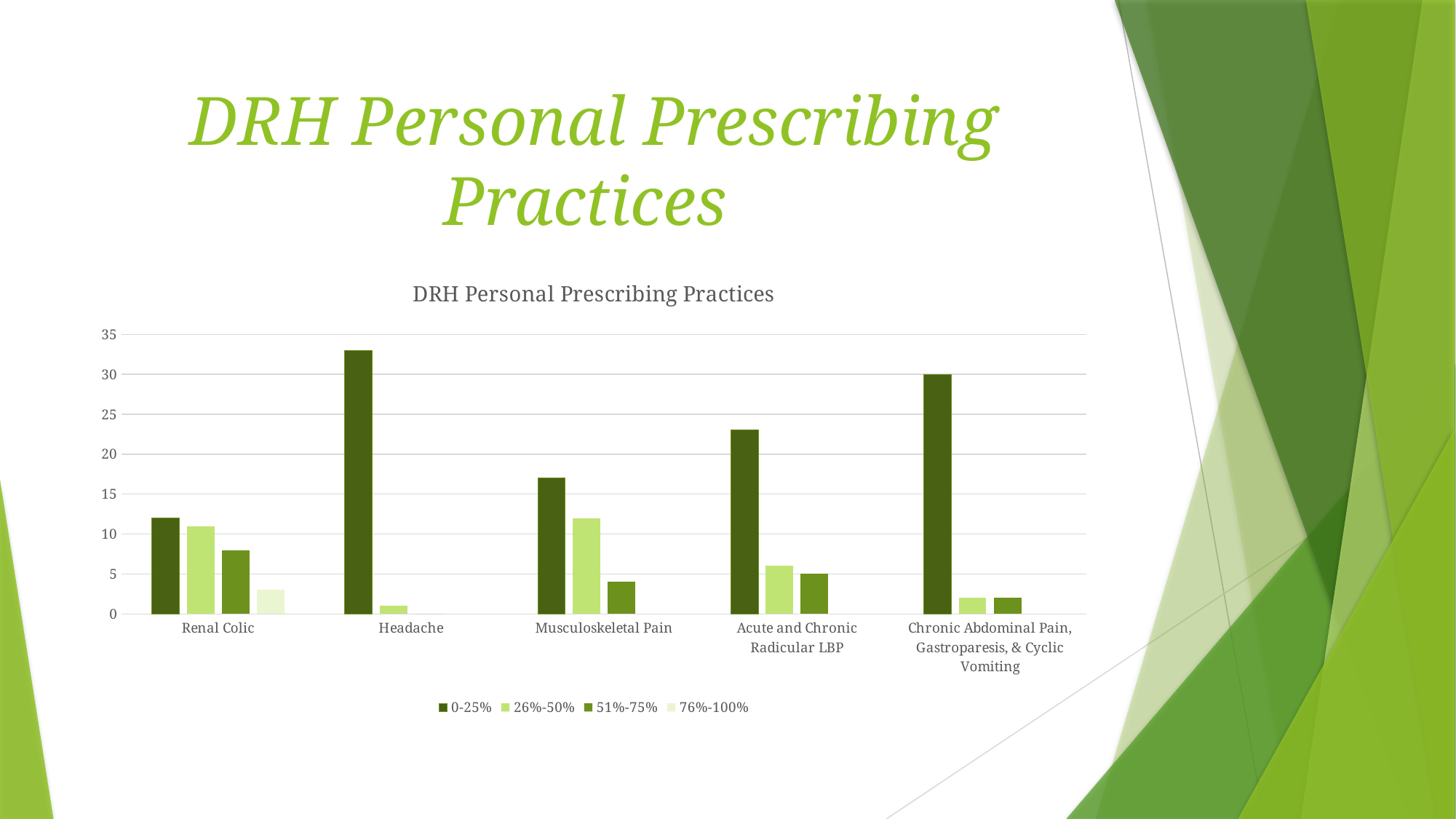
Is the value for Acute and Chronic Radicular LBP in the 0-25% series greater or less than 25? less Which category is the only one with a visible bar for the 76%-100% series? Renal Colic Is the value for Musculoskeletal Pain in the 0-25% series greater or less than 15? greater Which category has the lowest value for the 0-25% series? Renal Colic Is the value for Headache in the 0-25% series greater or less than 30? greater What kind of chart is shown on the slide? bar chart Which category has the highest value for the 0-25% series? Headache How many categories are shown along the x axis of the chart? 5 What is the title of the chart? DRH Personal Prescribing Practices How many series does the chart's legend list? 4 Which is larger: the 0-25% value for Headache or the 0-25% value for Chronic Abdominal Pain, Gastroparesis, & Cyclic Vomiting? Headache